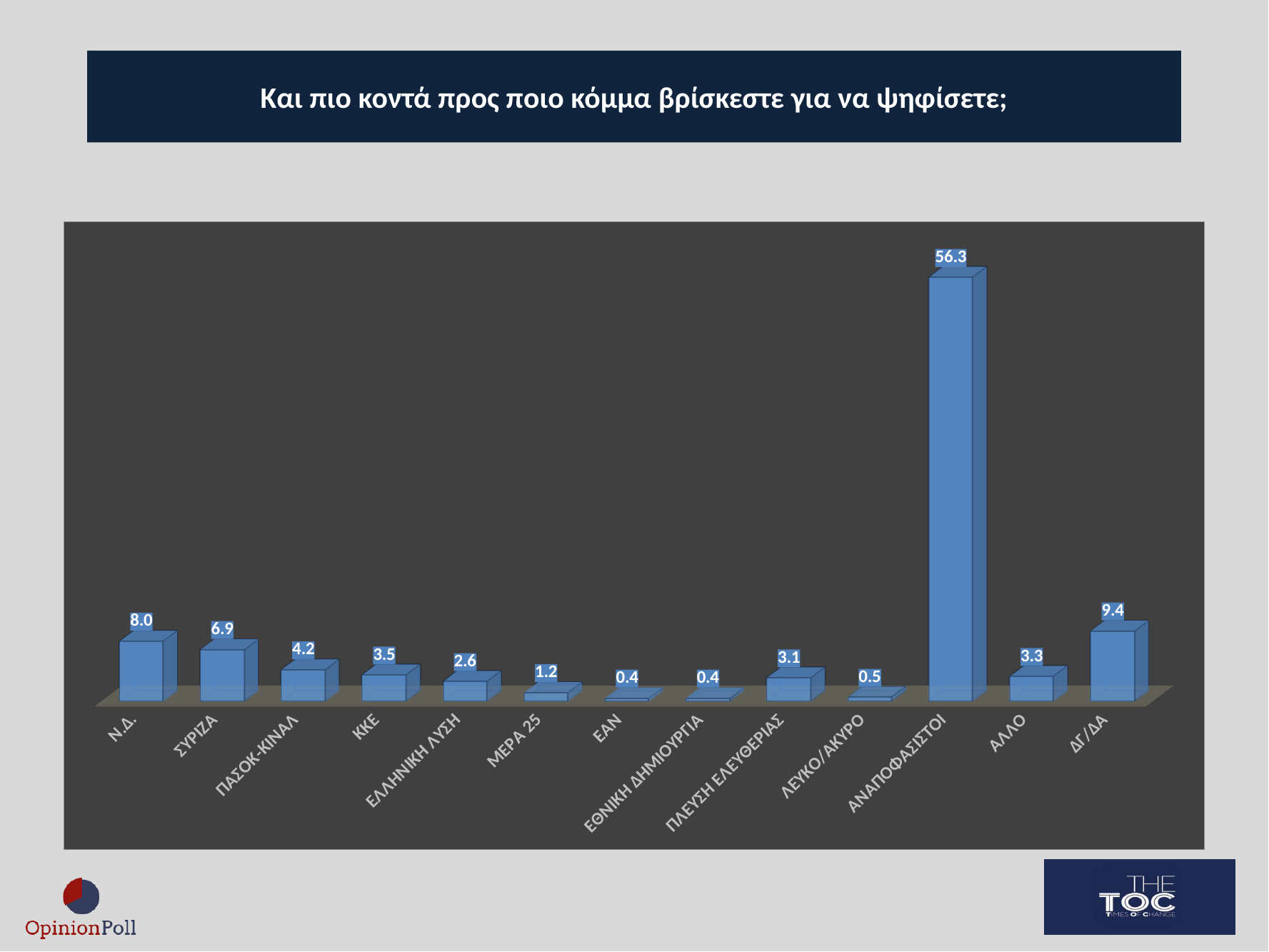
How many categories are shown in the chart? 13 What is the difference between the values for ΔΓ/ΔΑ and ΑΛΛΟ? 6.1 Which is larger, the value for ΜΕΡΑ 25 or the value for ΛΕΥΚΟ/ΑΚΥΡΟ? ΜΕΡΑ 25 What is the value for ΣΥΡΙΖΑ? 6.9 What kind of chart is shown on the slide? Bar chart What is the value for ΔΓ/ΔΑ? 9.4 What is the value for ΠΛΕΥΣΗ ΕΛΕΥΘΕΡΙΑΣ? 3.1 Which is larger, the value for ΚΚΕ or the value for ΠΑΣΟΚ-ΚΙΝΑΛ? ΠΑΣΟΚ-ΚΙΝΑΛ What is the difference between the values for Ν.Δ. and ΣΥΡΙΖΑ? 1.1 Which category has the highest value? ΑΝΑΠΟΦΑΣΙΣΤΟΙ What is the value for ΑΝΑΠΟΦΑΣΙΣΤΟΙ? 56.3 What is the value for Ν.Δ.? 8.0